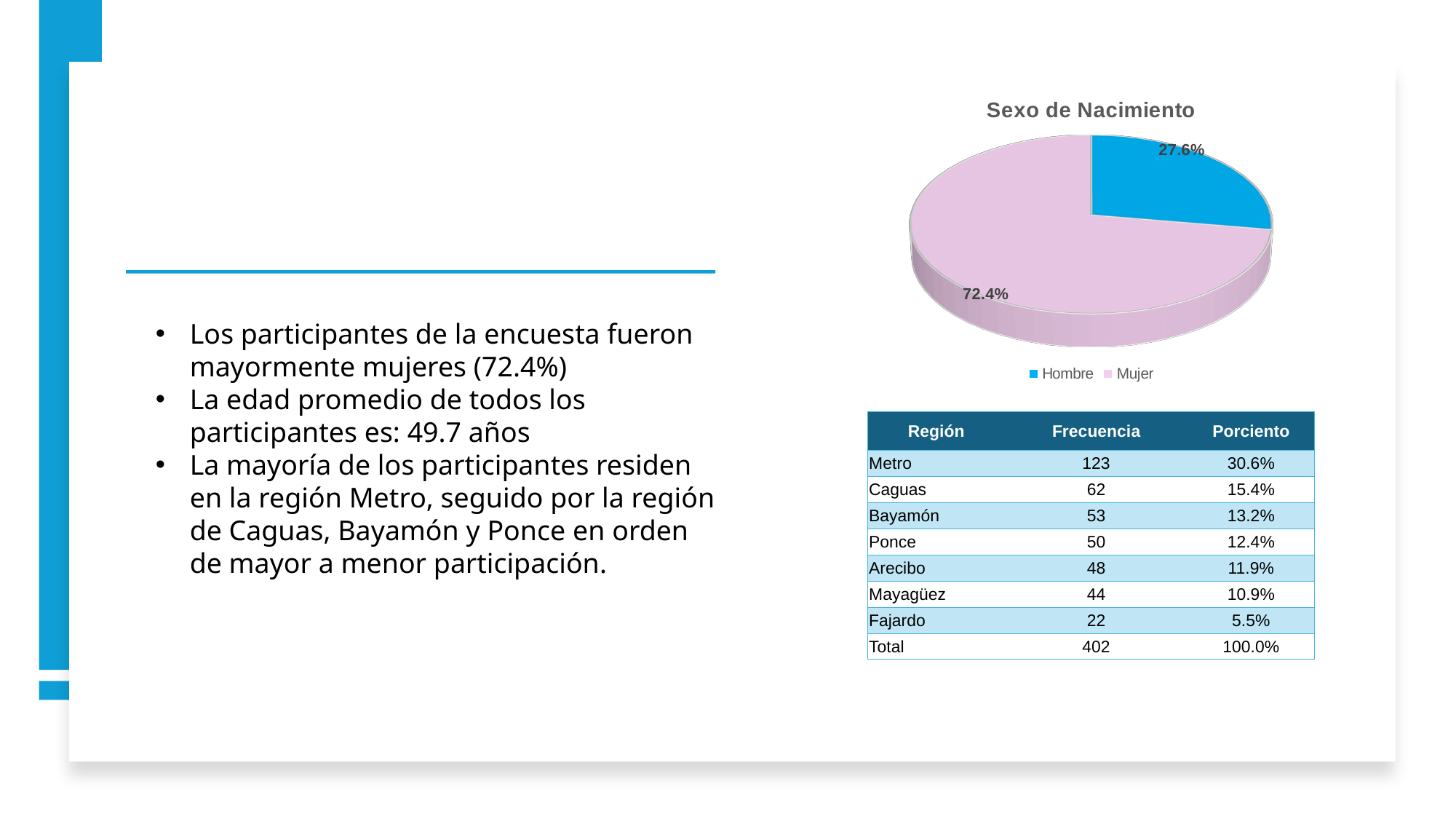
Is the Hombre share of the pie chart greater or less than 50%? less Which category has the smallest slice in the pie chart? Hombre What share of the pie chart is Hombre? 27.6% What type of chart is shown on the slide? pie chart What is the title of the pie chart? Sexo de Nacimiento How many categories does the pie chart legend list? 2 Which slice is larger, Hombre or Mujer? Mujer Which category has the largest slice in the pie chart? Mujer What share of the pie chart is Mujer? 72.4% Which colour represents Hombre in the pie chart? blue What is the difference in percentage points between the Mujer and Hombre slices? 44.8 How many slices does the pie chart have? 2